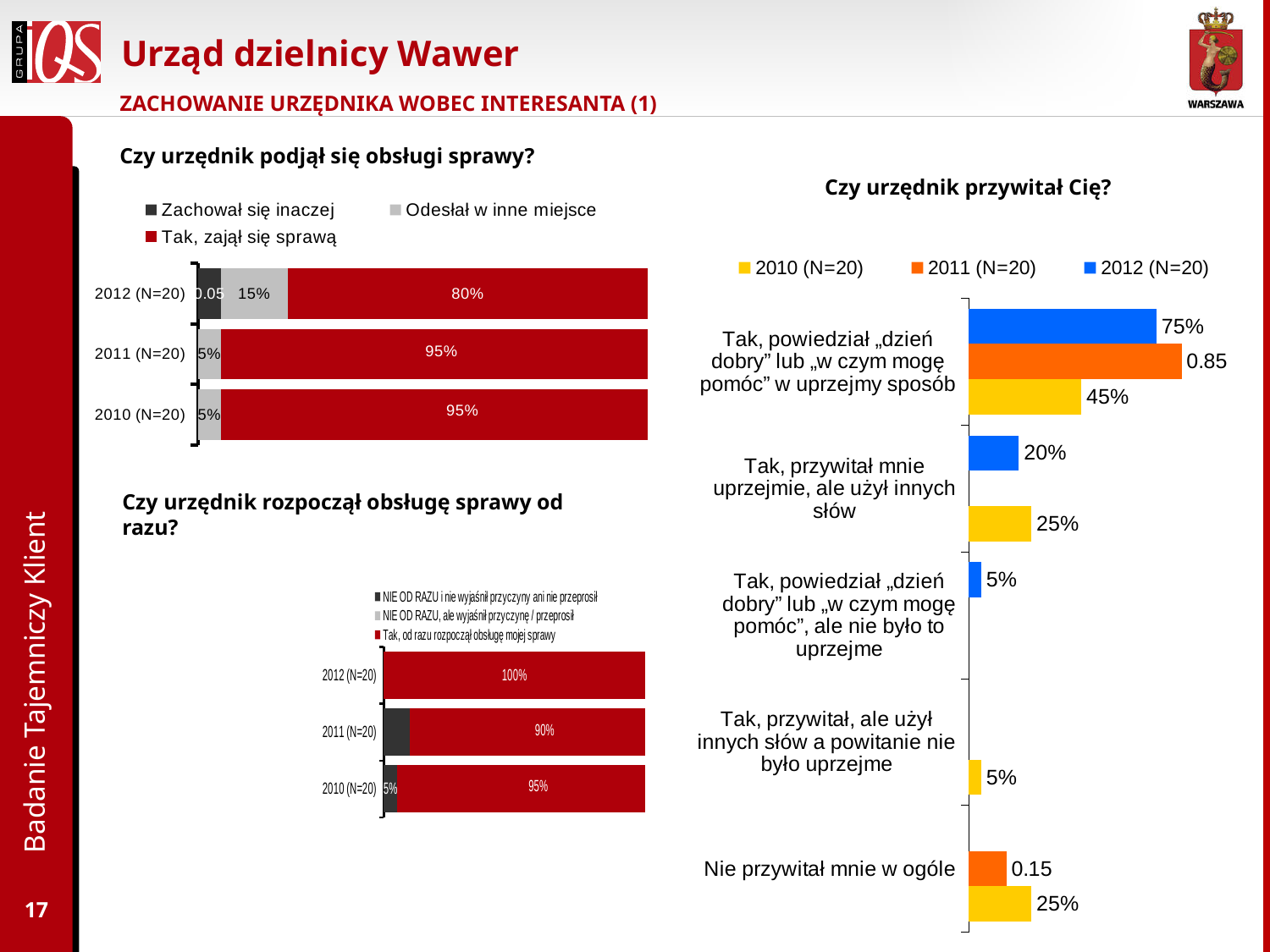
In the chart "Czy urzędnik przywitał Cię?", what is the value for 2010 (N=20) for "Nie przywitał mnie w ogóle"? 25% In the chart "Czy urzędnik podjął się obsługi sprawy?", what is the value of "Odesłał w inne miejsce" for 2012 (N=20)? 15% In the chart "Czy urzędnik przywitał Cię?", how many categories are shown on the axis? 5 In the chart "Czy urzędnik przywitał Cię?", how many series does the legend list? 3 In the chart "Czy urzędnik przywitał Cię?", which year has the highest value for "Tak, powiedział „dzień dobry” lub „w czym mogę pomóc” w uprzejmy sposób"? 2011 (N=20) What kind of chart is "Czy urzędnik rozpoczął obsługę sprawy od razu?"? Stacked bar chart In the chart "Czy urzędnik podjął się obsługi sprawy?", what is the value of "Tak, zajął się sprawą" for 2012 (N=20)? 80% In the chart "Czy urzędnik podjął się obsługi sprawy?", what is the difference between the "Tak, zajął się sprawą" values for 2011 (N=20) and 2012 (N=20)? 15% In the chart "Czy urzędnik przywitał Cię?", what is the value for 2010 (N=20) for "Tak, powiedział „dzień dobry” lub „w czym mogę pomóc” w uprzejmy sposób"? 45% In the chart "Czy urzędnik przywitał Cię?", is the value for 2012 (N=20) or 2010 (N=20) larger for "Tak, przywitał mnie uprzejmie, ale użył innych słów"? 2010 (N=20) In the chart "Czy urzędnik rozpoczął obsługę sprawy od razu?", what is the value of "Tak, od razu rozpoczął obsługę mojej sprawy" for 2012 (N=20)? 100% In the chart "Czy urzędnik przywitał Cię?", what is the value for 2012 (N=20) for "Tak, powiedział „dzień dobry” lub „w czym mogę pomóc” w uprzejmy sposób"? 75%